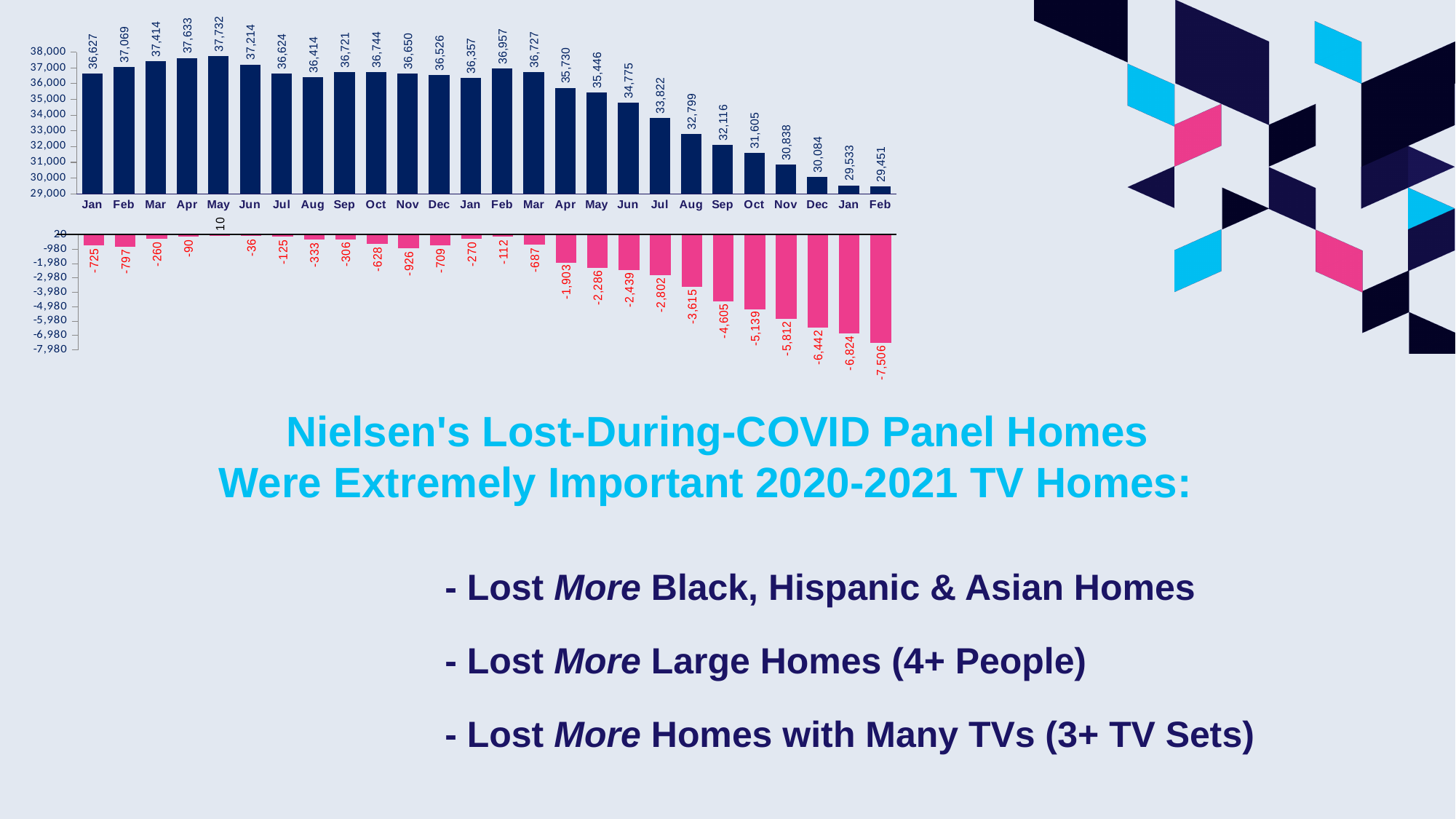
In the bottom chart, what is the value for the last Feb bar? -7,506 In the top chart, which month has the highest value? May (first May, 37,732) In the top chart, how many bars are plotted? 26 In the top chart, do the values rise or fall from the second Mar bar to the final Feb bar? Fall What kind of chart is the top chart? Bar chart In the top chart, what is the value for the last bar (the final Feb)? 29,451 In the bottom chart, which bar is the only one with a positive value? The first May (10) In the top chart, which bar has the lowest value? The last Feb (29,451) In the top chart, what is the value for the first May bar? 37,732 In the top chart, what is the difference between the first Jan value (36,627) and the last Jan value (29,533)? 7,094 In the bottom chart, is the value for the second Sep bar greater or less than -3,980? less In the bottom chart, what is the value for the first Nov bar? -926